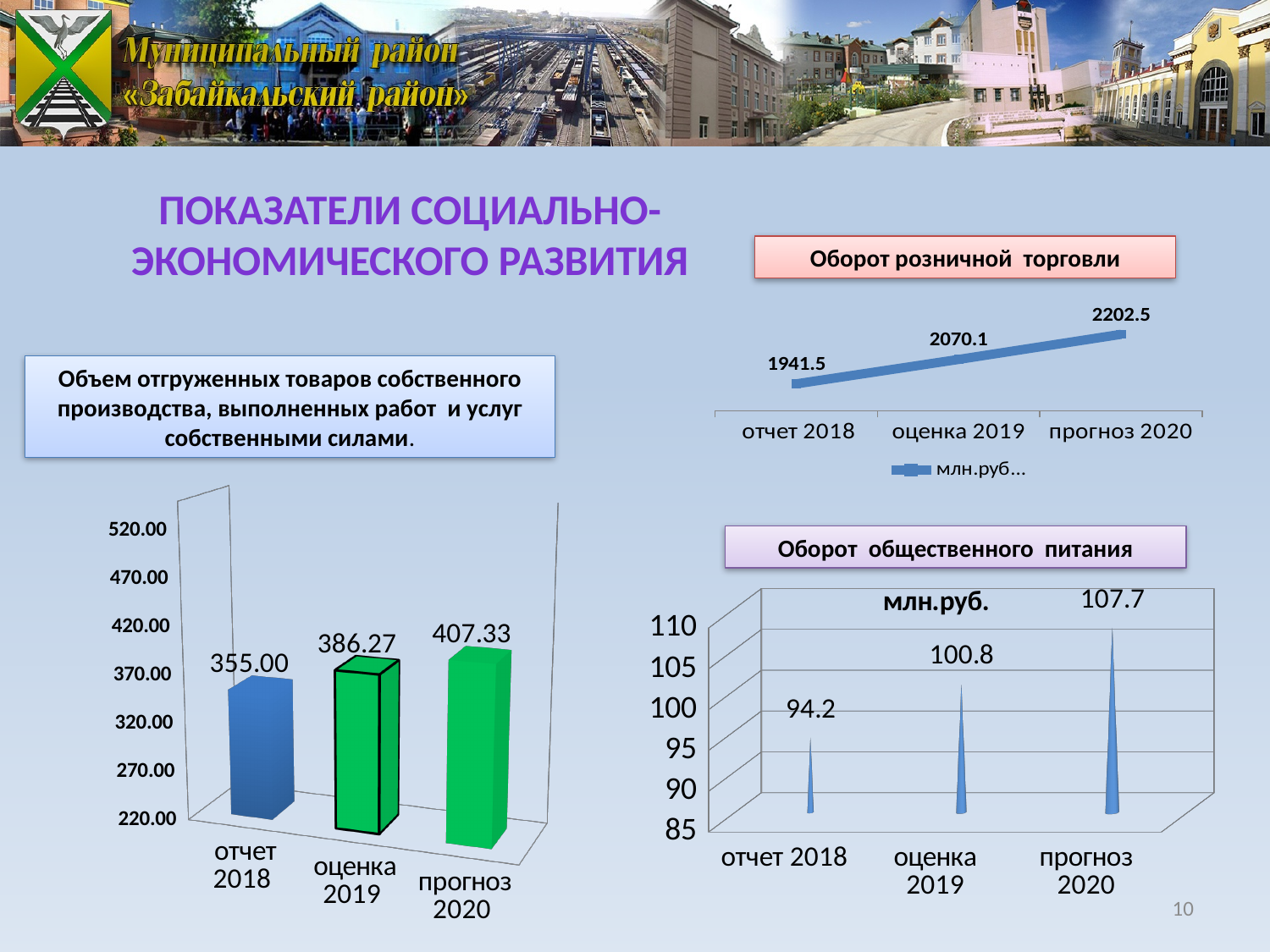
In the chart 'Объем отгруженных товаров собственного производства, выполненных работ и услуг собственными силами', what is the difference between 'прогноз 2020' and 'отчет 2018'? 52.33 In the chart 'Оборот общественного питания', how many categories are shown on the x axis? 3 In the chart 'Оборот розничной торговли', do the values rise or fall from 'отчет 2018' to 'прогноз 2020'? rise In the chart 'Оборот общественного питания', which category has the highest value? прогноз 2020 In the chart 'Оборот общественного питания', which is larger: 'отчет 2018' or 'оценка 2019'? оценка 2019 In the chart 'Оборот розничной торговли', what is the difference between 'оценка 2019' and 'отчет 2018'? 128.6 In the chart 'Объем отгруженных товаров собственного производства, выполненных работ и услуг собственными силами', which category has the lowest value? отчет 2018 What kind of chart is 'Объем отгруженных товаров собственного производства, выполненных работ и услуг собственными силами'? bar chart In the chart 'Оборот розничной торговли', what is the value for 'прогноз 2020'? 2202.5 In the chart 'Оборот общественного питания', what is the value for 'оценка 2019'? 100.8 In the chart 'Объем отгруженных товаров собственного производства, выполненных работ и услуг собственными силами', what is the value for 'оценка 2019'? 386.27 In the chart 'Оборот розничной торговли', what is the value for 'отчет 2018'? 1941.5